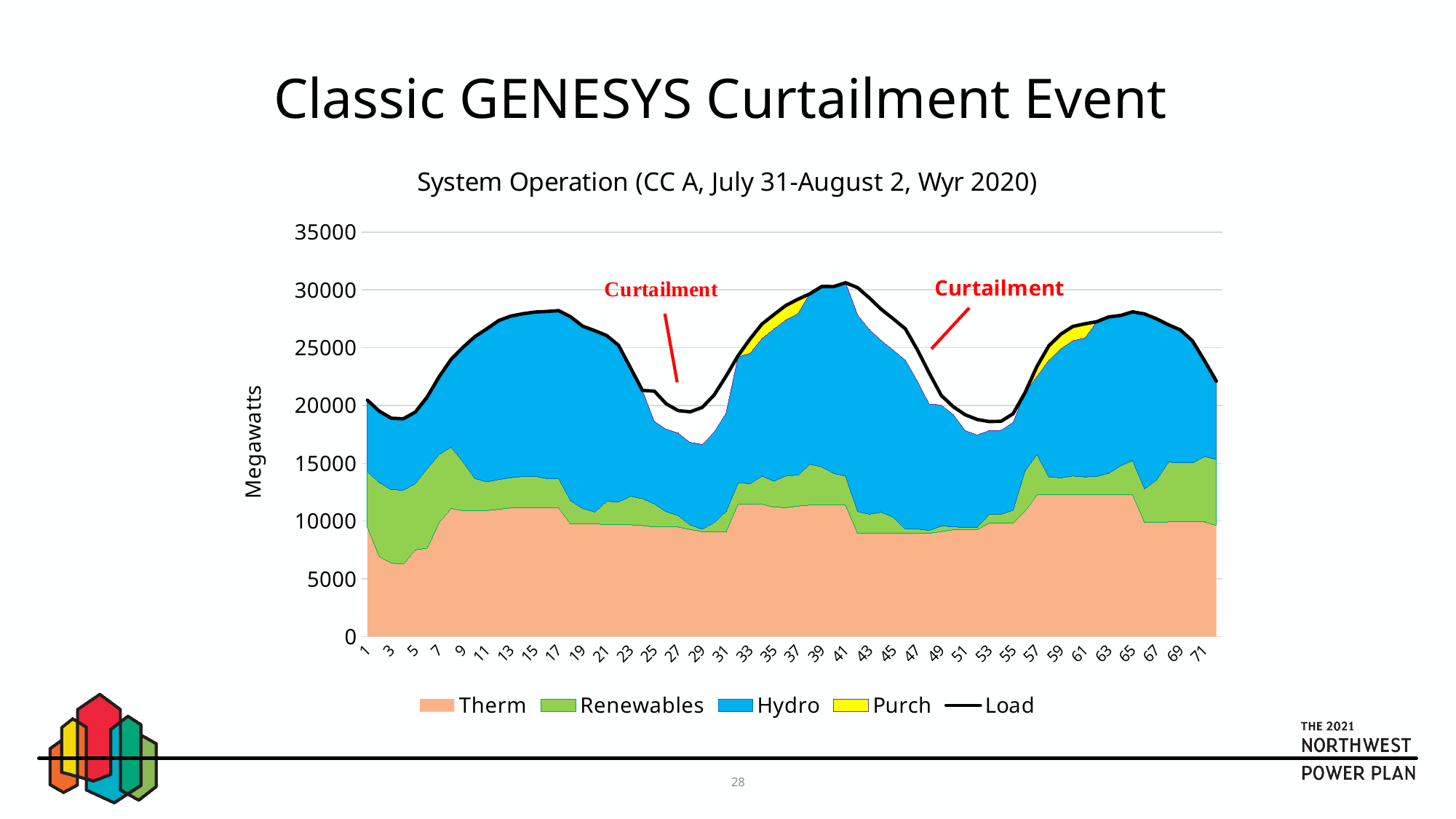
What is the title of the chart? System Operation (CC A, July 31-August 2, Wyr 2020) Is the Load value at hour 17 greater or less than 25000? greater What is the label on the vertical axis? Megawatts Around which hour does the Load line reach its highest value? 41 Is the Load value at hour 3 greater or less than 20000? less What is the highest value shown on the vertical axis? 35000 What kind of chart is shown on the slide? Stacked area chart with a line Is the Therm value at hour 3 greater or less than 10000? less Does the Load line rise or fall between hour 41 and hour 53? fall How many series does the legend list? 5 Does the Load line rise or fall between hour 3 and hour 17? rise